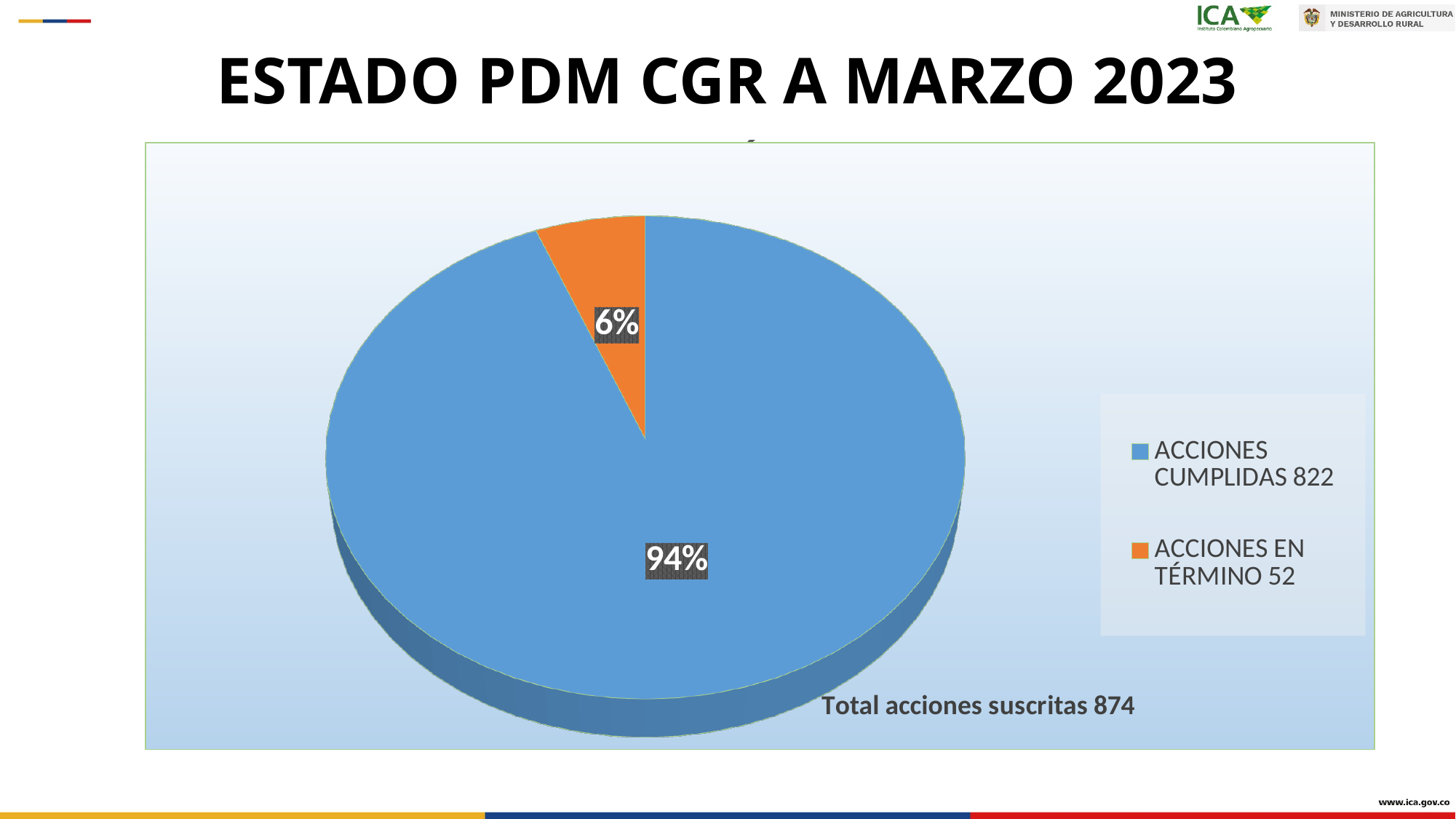
What is the total number of acciones suscritas shown on the chart? 874 Which category has the largest slice of the pie? ACCIONES CUMPLIDAS How many ACCIONES CUMPLIDAS are there according to the legend? 822 What colour is the slice for ACCIONES EN TÉRMINO? orange Which category has the smallest slice of the pie? ACCIONES EN TÉRMINO What kind of chart is shown on the slide? pie chart How many categories does the pie chart have? 2 Which is larger, ACCIONES CUMPLIDAS or ACCIONES EN TÉRMINO? ACCIONES CUMPLIDAS How many ACCIONES EN TÉRMINO are there according to the legend? 52 What percentage share of the pie does ACCIONES CUMPLIDAS represent? 94% What is the difference between the number of ACCIONES CUMPLIDAS and ACCIONES EN TÉRMINO? 770 What percentage share of the pie does ACCIONES EN TÉRMINO represent? 6%